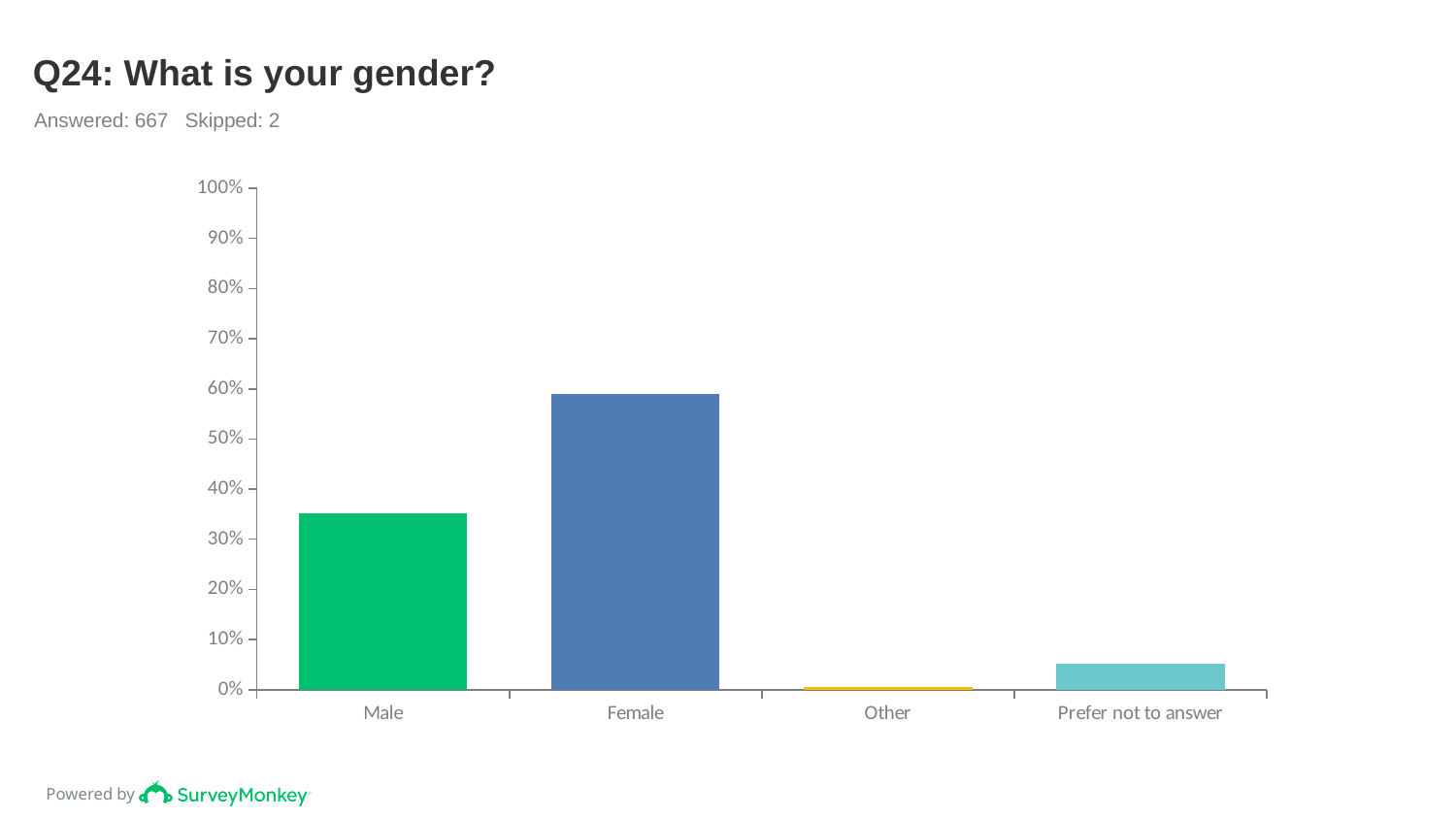
Is the value for Prefer not to answer greater or less than 10%? less What kind of chart is shown on the slide? bar chart How many respondents answered the question according to the slide? 667 What is the title of the chart on the slide? Q24: What is your gender? Which is larger, the value for Male or the value for Female? Female Which is larger, the value for Prefer not to answer or the value for Other? Prefer not to answer Is the value for Female greater or less than 50%? greater How many categories are shown on the x axis of the chart? 4 Is the value for Male greater or less than 40%? less Which category has the highest value in the chart? Female Which category has the lowest value in the chart? Other